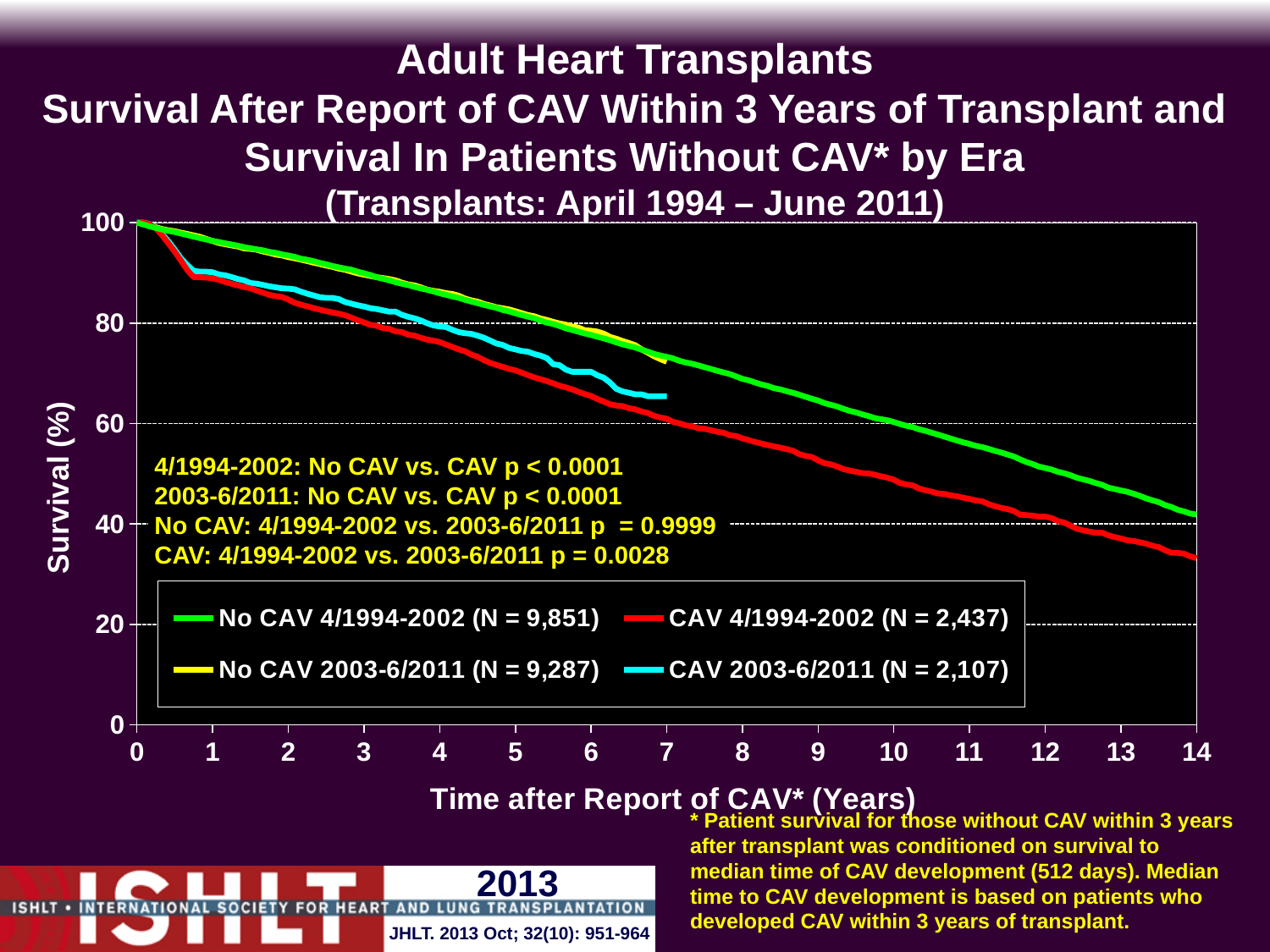
Is the survival value for No CAV 4/1994-2002 at 14 years greater or less than 40? greater What is the N for the CAV 2003-6/2011 series shown in the legend? 2,107 At 14 years, which series has higher survival: No CAV 4/1994-2002 or CAV 4/1994-2002? No CAV 4/1994-2002 What p-value is given for CAV: 4/1994-2002 vs. 2003-6/2011? 0.0028 Is the survival value for CAV 4/1994-2002 at 14 years greater or less than 40? less Do the survival curves rise or fall as time after report of CAV increases? fall What is the N for the No CAV 4/1994-2002 series shown in the legend? 9,851 How many series does the legend list? 4 What kind of chart is shown on the slide? line chart What is the highest value shown on the x axis (Time after Report of CAV, years)? 14 What p-value is given for No CAV: 4/1994-2002 vs. 2003-6/2011? 0.9999 Is the survival value for CAV 4/1994-2002 at 4 years greater or less than 80? less